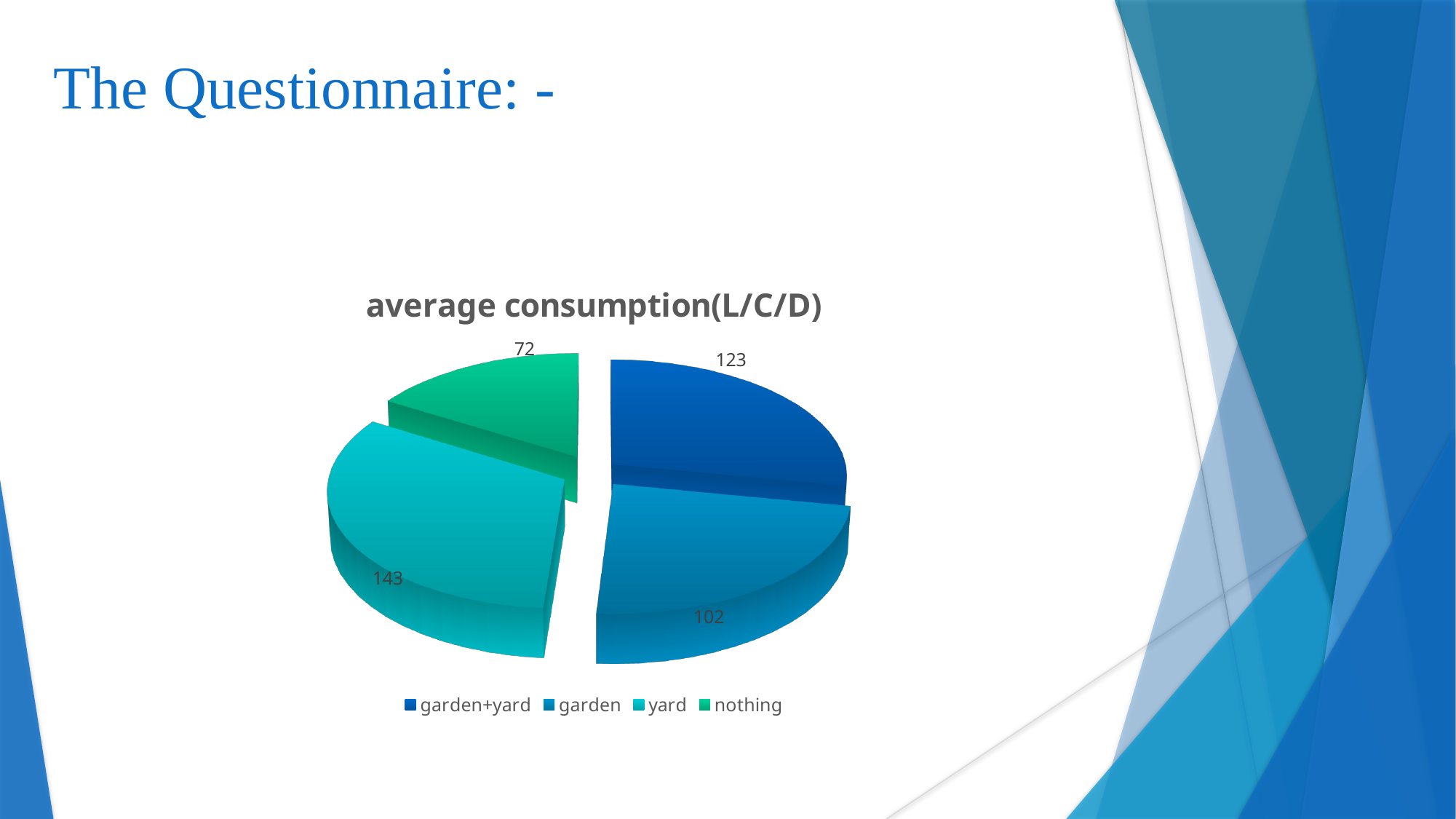
What is the title of the chart? average consumption(L/C/D) What is the difference between the yard value and the nothing value? 71 Which category has the lowest value? nothing What is the value for the nothing slice? 72 Which category has the highest value? yard Which is larger, garden+yard or garden? garden+yard What is the value for the yard slice? 143 What share of the pie does the yard slice represent? 32.5% How many slices does the pie chart have? 4 What is the value for the garden+yard slice? 123 What type of chart is shown on the slide? pie chart What is the value for the garden slice? 102